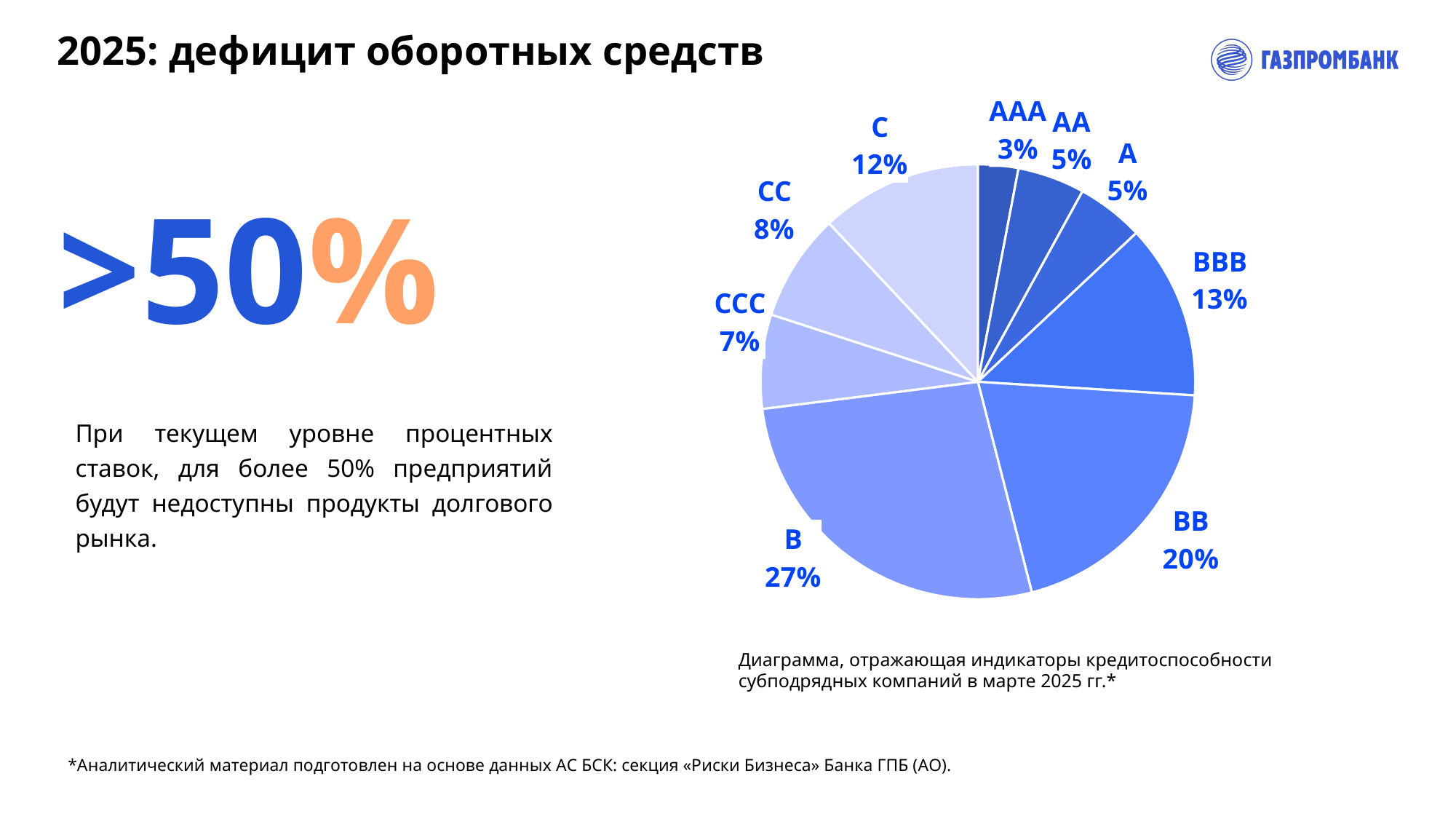
How many categories (slices) does the pie chart have? 9 What is the value shown for the BBB slice? 13% Which rating category has the largest slice of the pie chart? B What share of the pie chart does the B rating category have? 27% What is the combined share of the AAA, AA and A slices? 13% What type of chart is shown on the slide? pie chart Which rating category has the smallest slice of the pie chart? AAA Which is larger, the C slice or the CCC slice? C According to the caption, what does the pie chart reflect? Индикаторы кредитоспособности субподрядных компаний в марте 2025 гг. What is the value shown for the CC slice? 8% What is the difference between the B share and the C share? 15% What is the difference between the BB and BBB shares? 7%